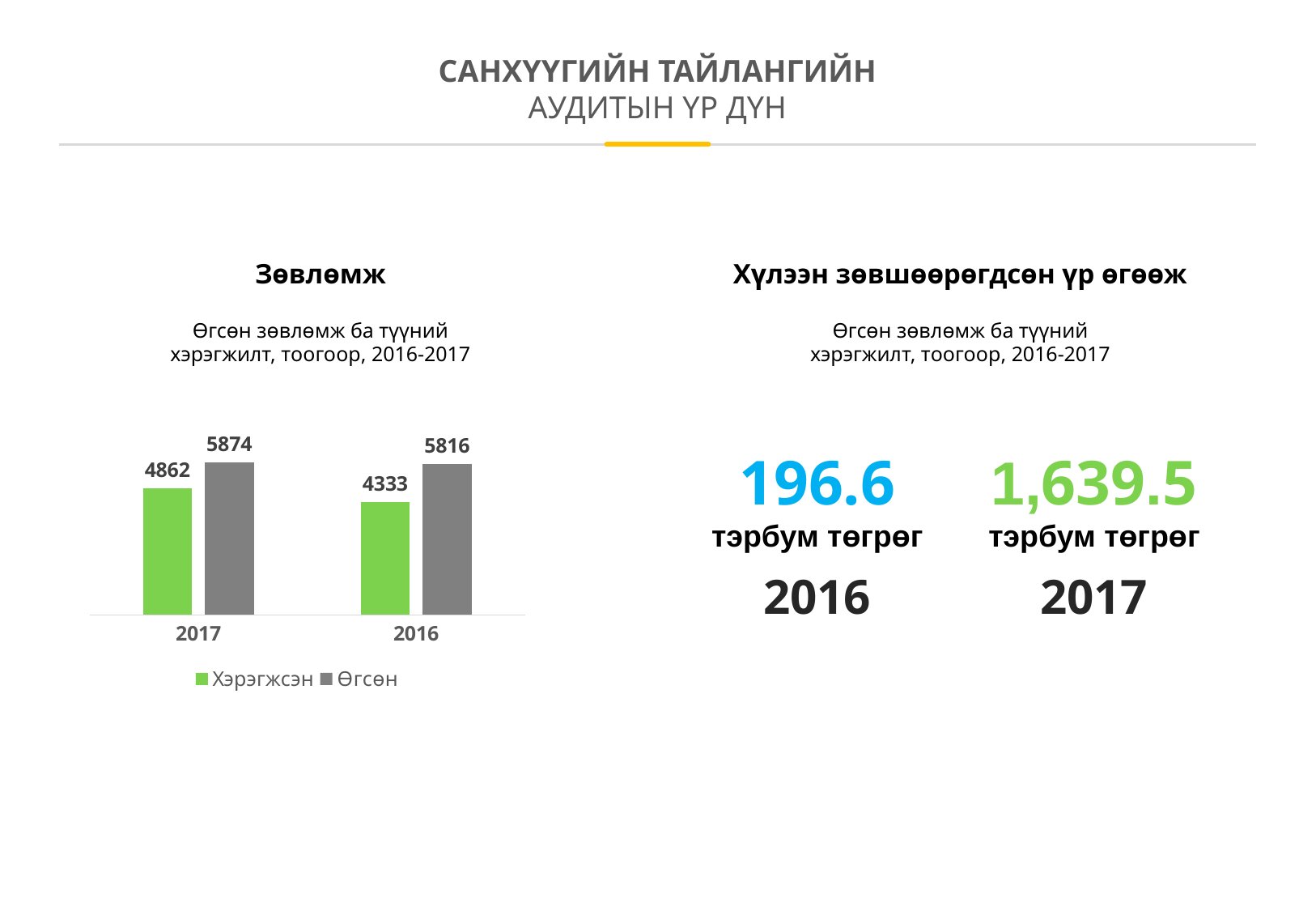
In the "Зөвлөмж" chart, what is the value of Өгсөн for 2017? 5874 In the "Зөвлөмж" chart, is Өгсөн for 2017 larger or smaller than Өгсөн for 2016? Larger In the "Зөвлөмж" chart, what is the difference between Өгсөн and Хэрэгжсэн for 2016? 1483 In the "Зөвлөмж" chart, what is the difference between Өгсөн and Хэрэгжсэн for 2017? 1012 In the "Зөвлөмж" chart, which series is shown in green? Хэрэгжсэн What type of chart is shown under the heading "Зөвлөмж"? Bar chart In the "Зөвлөмж" chart, what is the value of Хэрэгжсэн for 2017? 4862 In the "Зөвлөмж" chart, which bar has the lowest value overall? Хэрэгжсэн for 2016 In the "Зөвлөмж" chart, which year has the higher Хэрэгжсэн value? 2017 How many series does the legend of the "Зөвлөмж" chart list? 2 In the "Зөвлөмж" chart, what is the value of Хэрэгжсэн for 2016? 4333 In the "Зөвлөмж" chart, what is the value of Өгсөн for 2016? 5816